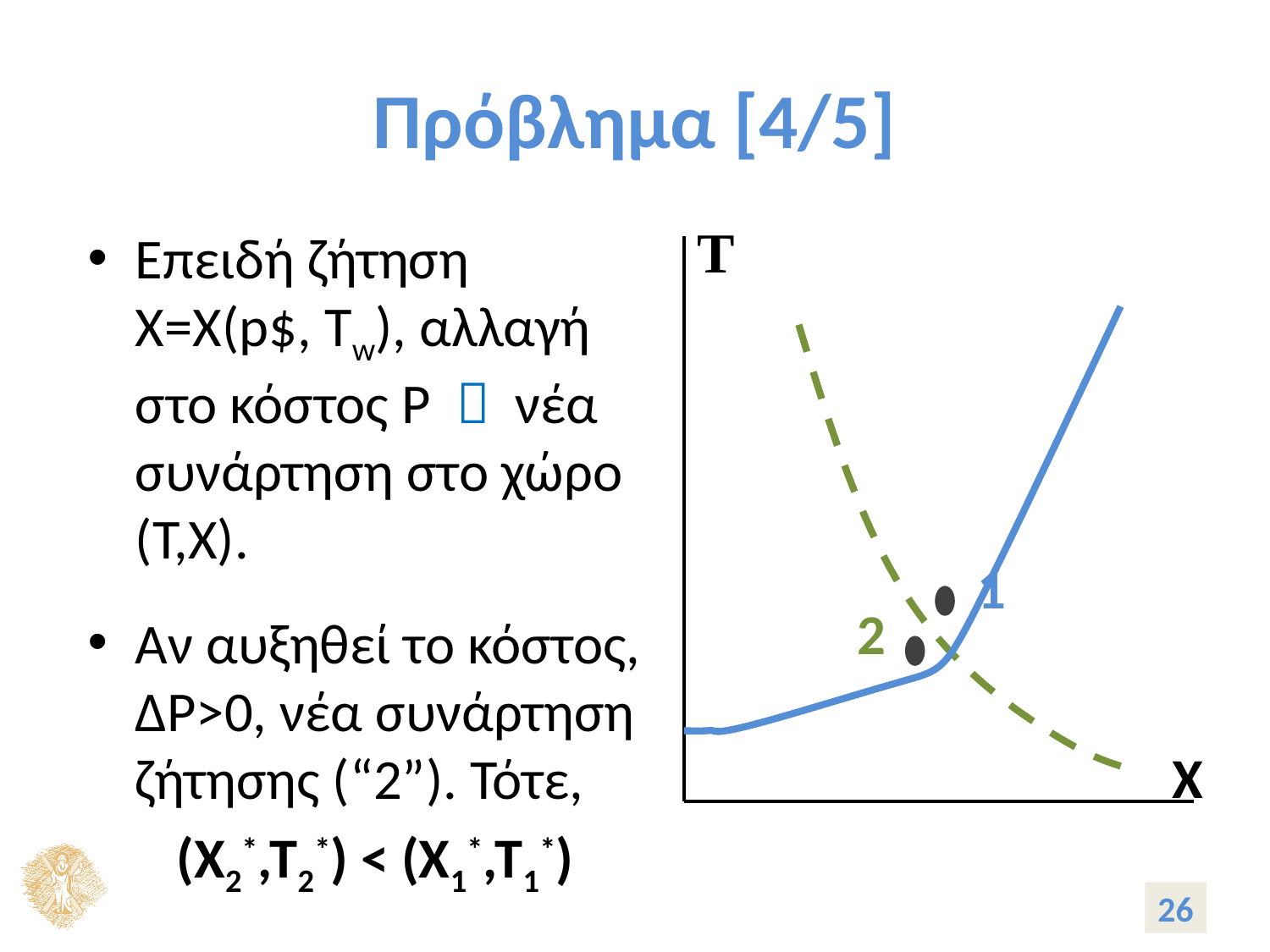
What is the label on the horizontal axis of the chart? X How many labelled points are marked on the chart? 2 Which labelled point is lowest on the T axis? point 2 What kind of chart is shown on the slide? line chart What is the label on the vertical axis of the chart? T Which labelled point has the larger X value, point 1 or point 2? point 1 Which labelled point has the higher T value, point 1 or point 2? point 1 How many curves are drawn on the chart? 2 Does the dashed green line rise or fall as X increases? fall Does the solid blue line rise or fall as X increases? rise